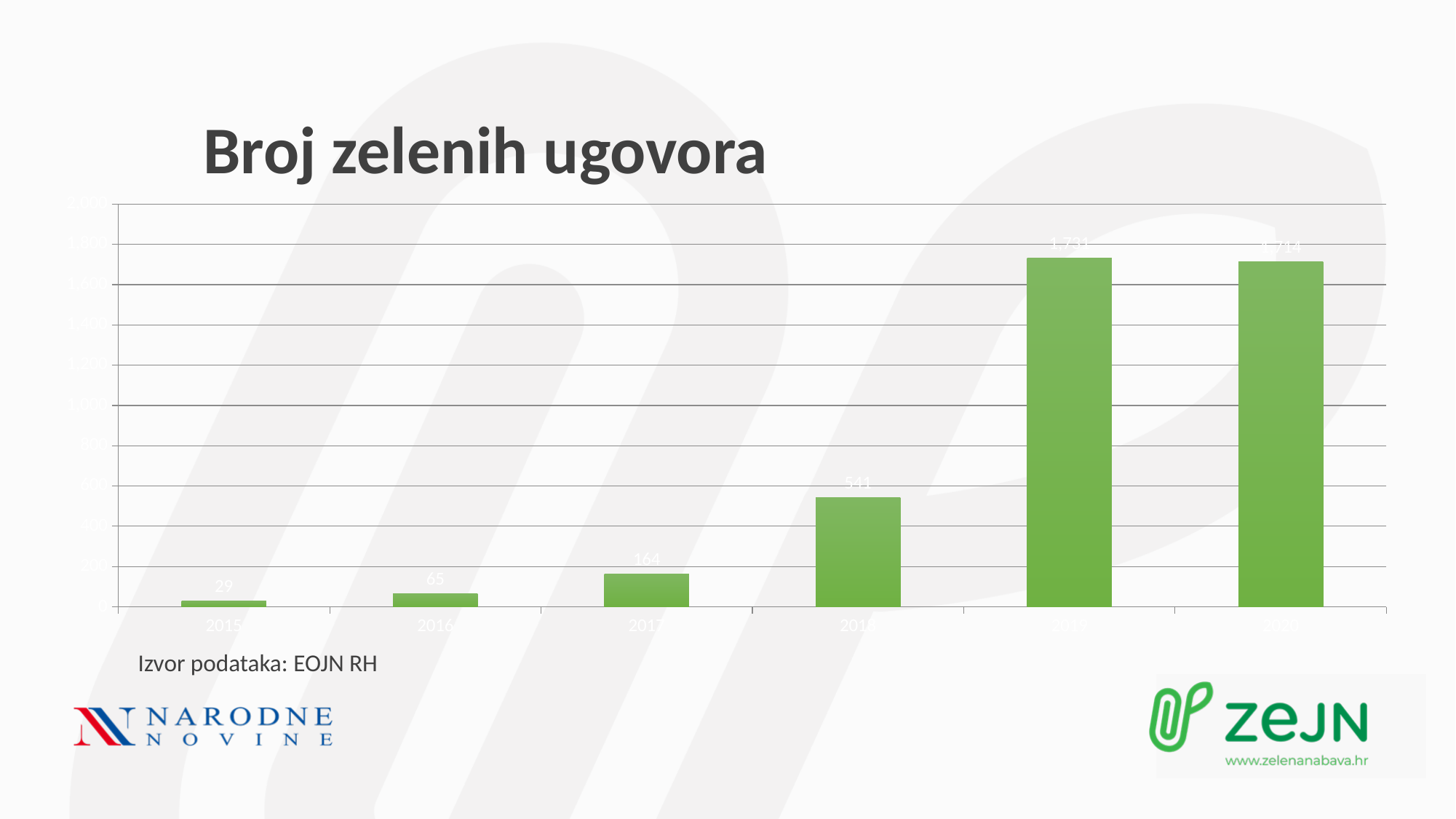
Which year has the lowest value? 2015 What is the value for 2017? 164 Which is larger, the value for 2017 or the value for 2018? 2018 How many years are shown on the x axis of the chart? 6 What is the value for 2015? 29 What is the value for 2018? 541 What is the value for 2016? 65 Is the value for 2018 greater or less than 600? less What is the difference between the values for 2018 and 2017? 377 What is the title of the chart? Broj zelenih ugovora Which year has the highest value? 2019 What kind of chart is shown on the slide? bar chart